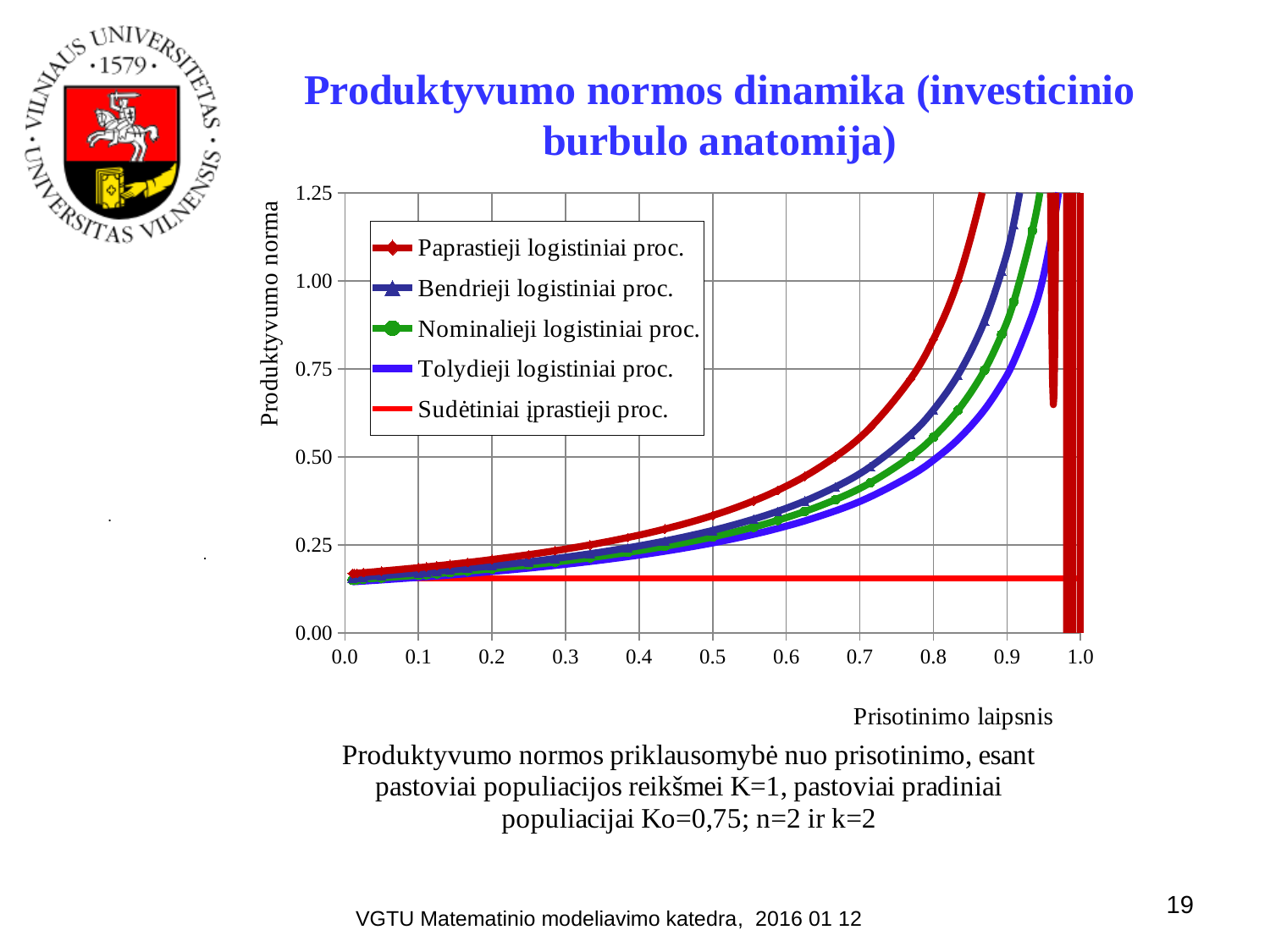
Is the value of the Paprastieji logistiniai proc. series at x = 0.5 greater or less than 0.50? less Which series has the highest value at x = 0.8? Paprastieji logistiniai proc. Does the value of the Paprastieji logistiniai proc. series rise or fall as the x axis increases? rise What is the highest tick value shown on the y axis? 1.25 Which series has the lowest value at x = 0.8? Sudėtiniai įprastieji proc. What kind of chart is shown on the slide? line chart Is the value of the Tolydieji logistiniai proc. series at x = 0.9 greater or less than 0.50? greater What is the label of the x axis? Prisotinimo laipsnis Is the value of the Sudėtiniai įprastieji proc. series at x = 0.5 greater or less than 0.25? less How many series does the legend list? 5 What is the label of the y axis? Produktyvumo norma At x = 0.6, which is larger: the Paprastieji logistiniai proc. series or the Tolydieji logistiniai proc. series? Paprastieji logistiniai proc.